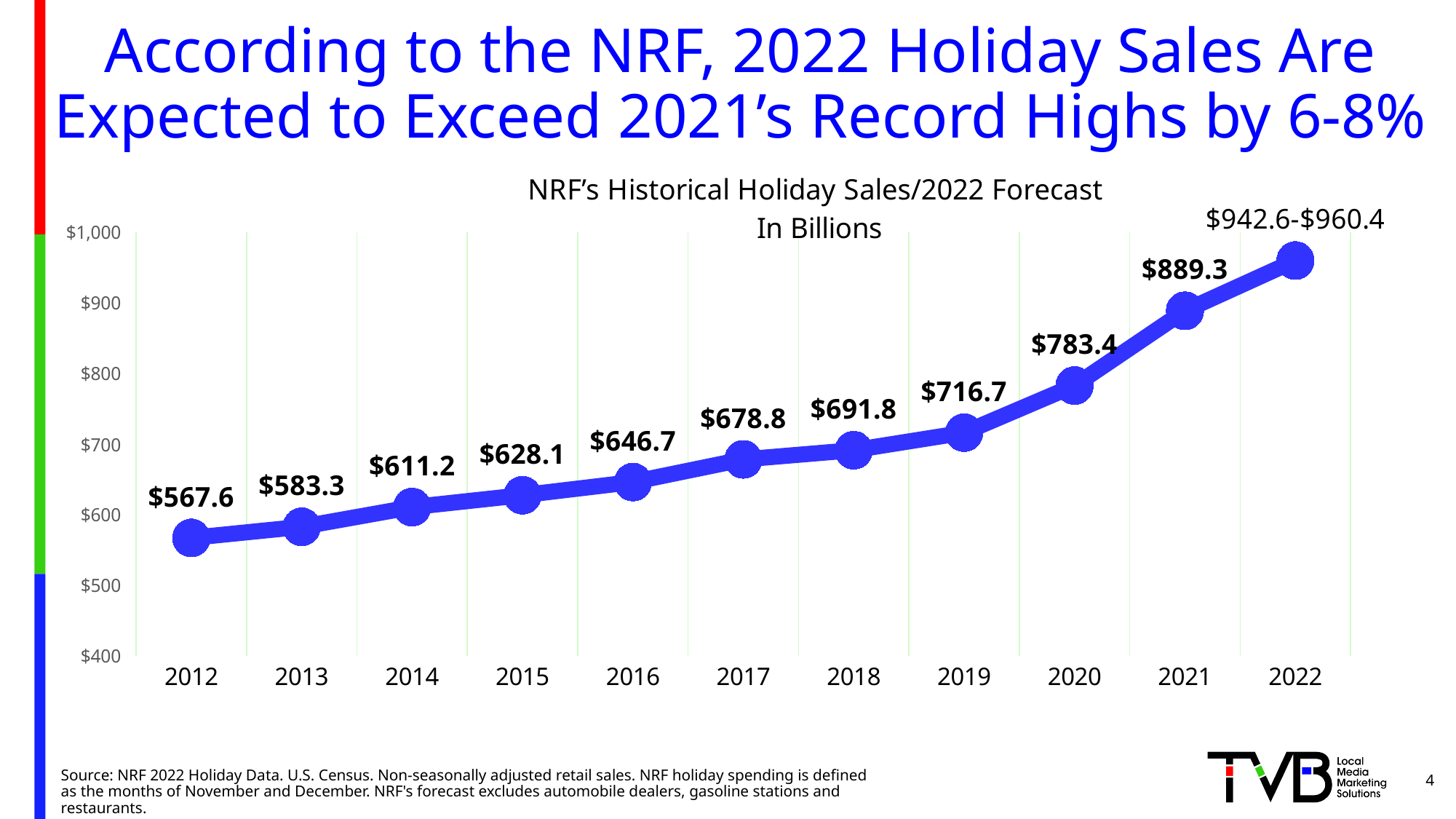
What is the value for 2012? $567.6 Which year has the lowest value? 2012 What is the value for 2021? $889.3 Which year has the highest value? 2022 What is the forecast range shown for 2022? $942.6-$960.4 What is the difference between the values for 2021 and 2020? $105.9 What kind of chart is shown? line chart Is the value for 2020 greater or less than $700? greater How many years are plotted on the chart? 11 Which is larger, the value for 2019 or the value for 2018? 2019 What is the value for 2017? $678.8 Do the values rise or fall from 2012 to 2022? rise